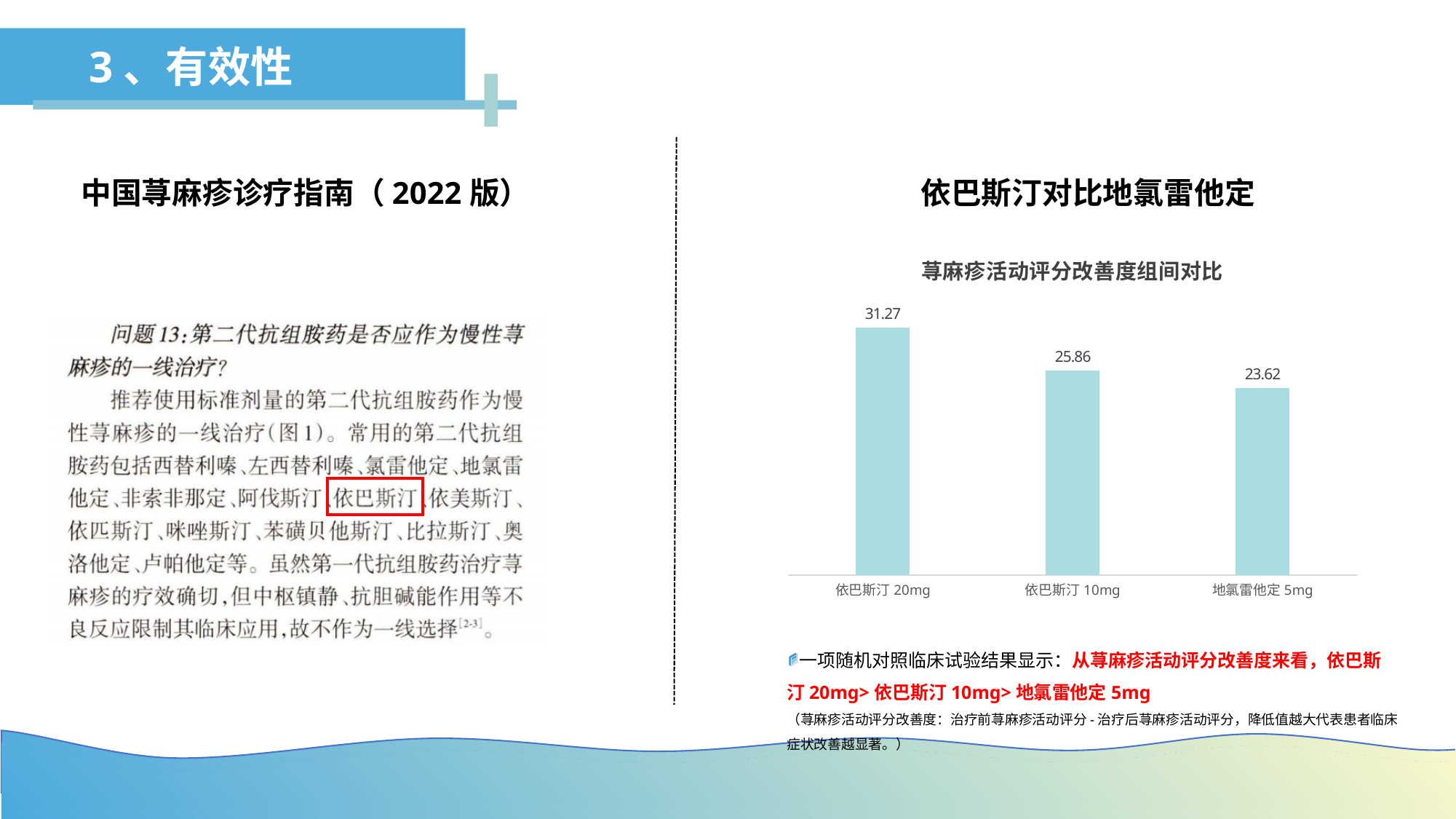
What kind of chart is shown on the slide? Bar chart What is the value for 地氯雷他定 5mg in the chart? 23.62 Which category has the lowest value in the chart? 地氯雷他定 5mg What is the value for 依巴斯汀 10mg in the chart? 25.86 What is the title of the chart? 荨麻疹活动评分改善度组间对比 What is the value for 依巴斯汀 20mg in the chart? 31.27 Do the values rise or fall from left to right across the chart? Fall What is the difference between the values for 依巴斯汀 20mg and 依巴斯汀 10mg? 5.41 Which category has the highest value in the chart? 依巴斯汀 20mg What is the difference between the values for 依巴斯汀 10mg and 地氯雷他定 5mg? 2.24 Which is larger, the value for 依巴斯汀 10mg or the value for 地氯雷他定 5mg? 依巴斯汀 10mg How many categories are shown in the chart? 3